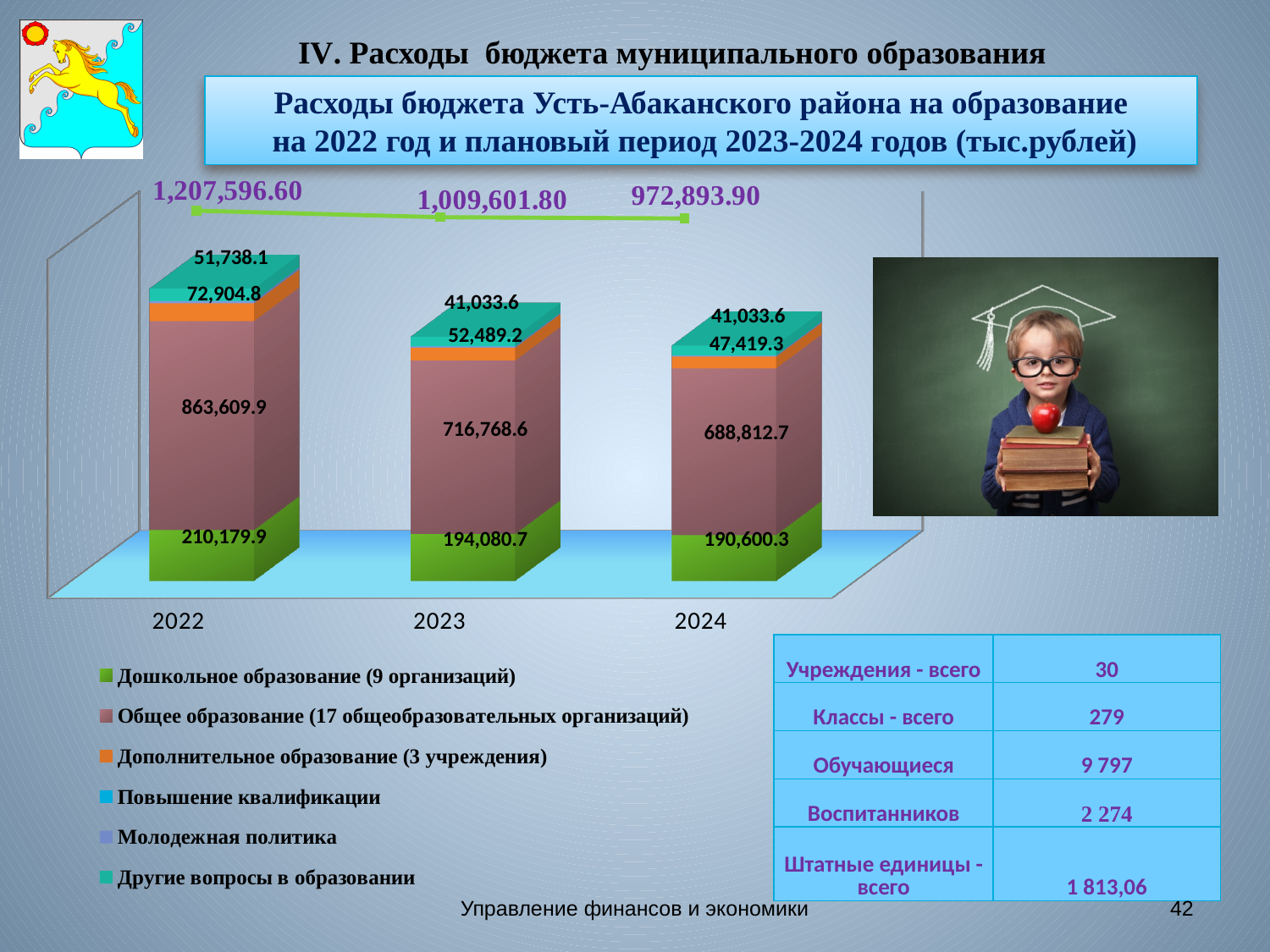
What is the value for Дополнительное образование in 2023? 52,489.2 In which year is the value for Общее образование the lowest? 2024 Which is larger: Дополнительное образование in 2022 or in 2024? 2022 What is the difference between the total expenditure for 2023 and 2024? 36,707.90 How many series does the legend list? 6 How many years are shown on the x axis of the chart? 3 Which year has the highest total education expenditure? 2022 What is the total education expenditure shown for 2022? 1,207,596.60 What is the value for Общее образование in 2024? 688,812.7 What is the value for Дошкольное образование in 2022? 210,179.9 What is the difference between the Дошкольное образование values for 2022 and 2024? 19,579.6 Do the total expenditure values rise or fall from 2022 to 2024? fall